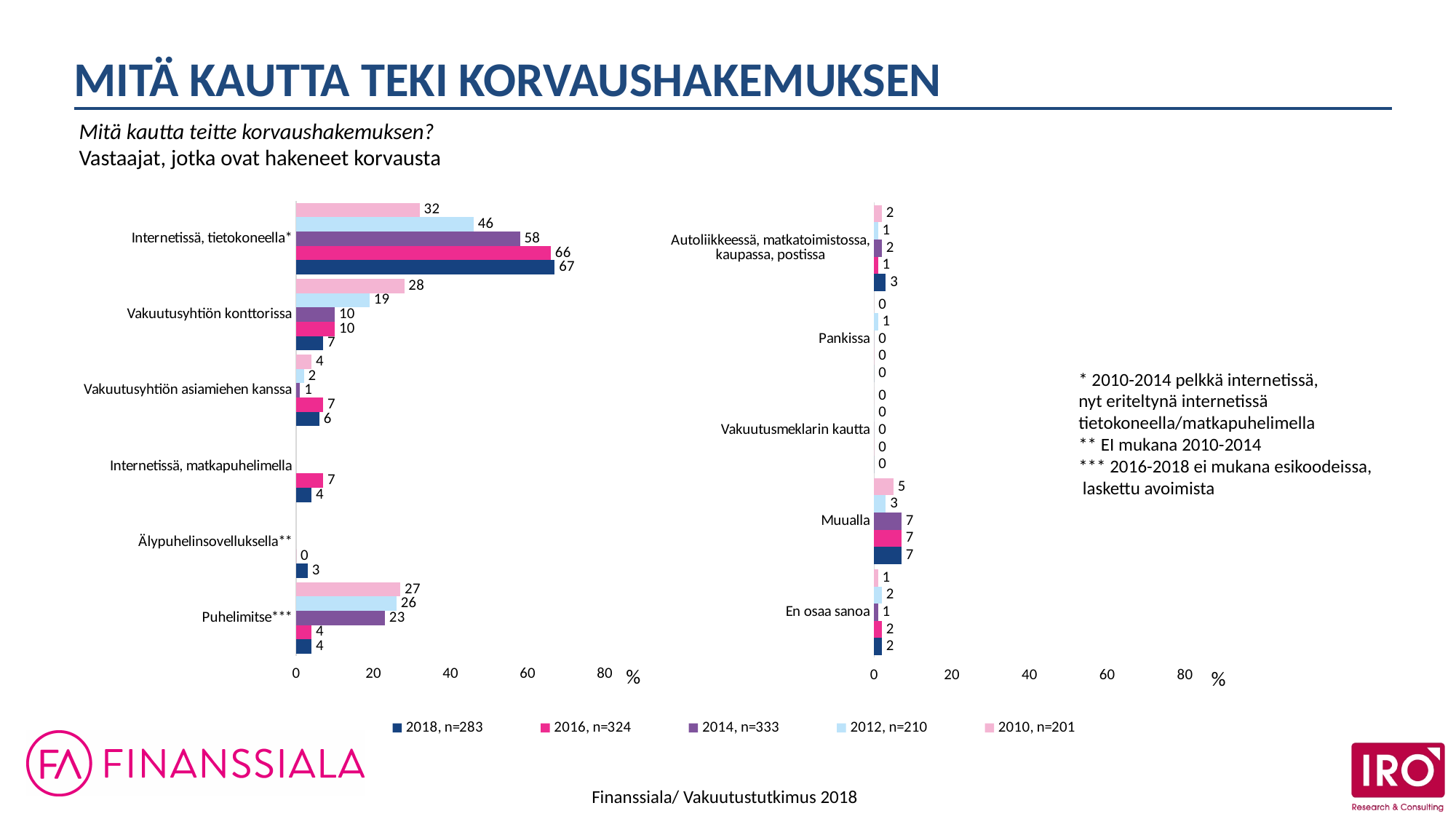
On the left chart, what is the 2014 value for Puhelimitse***? 23 On the left chart, what is the difference between the 2018 and 2010 values for Internetissä, tietokoneella*? 35 On the left chart, what is the 2010 value for Vakuutusyhtiön konttorissa? 28 On the left chart, which is larger for Puhelimitse***: the 2012 value or the 2016 value? 2012 On the right chart, what is the 2018 value for Autoliikkeessä, matkatoimistossa, kaupassa, postissa? 3 What kind of chart is shown on the left? bar chart On the right chart, what is the 2010 value for Muualla? 5 On the right chart, how many categories are shown? 5 How many series does the legend list? 5 On the left chart, does the 2018 value for Internetissä, tietokoneella* rise or fall from 2010 to 2018? rise On the left chart, which category has the highest 2018 value? Internetissä, tietokoneella* On the left chart, what is the 2018 value for Internetissä, tietokoneella*? 67